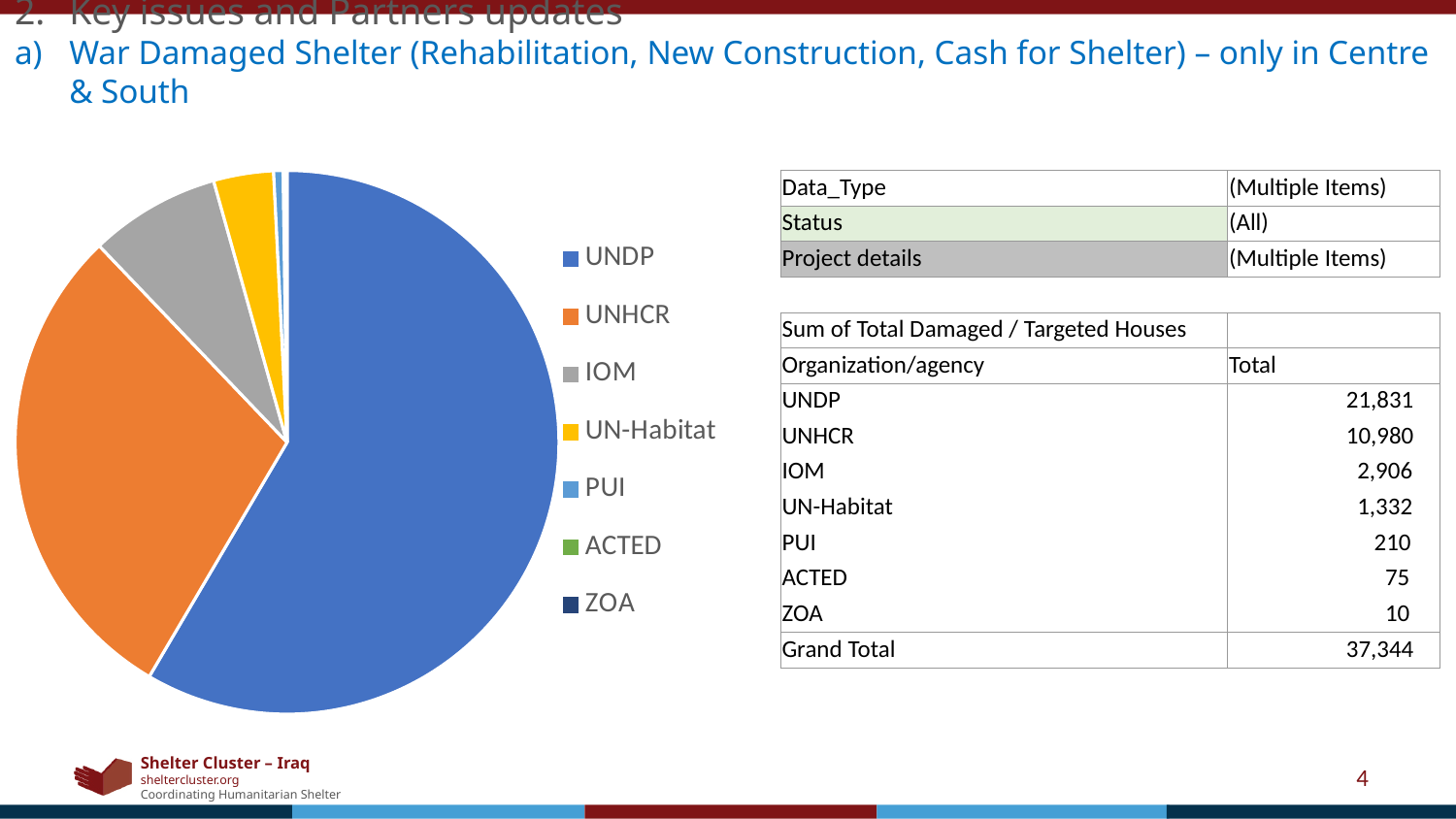
How many entries does the pie chart's legend list? 7 Which organization has the smallest value in the table of Total Damaged / Targeted Houses? ZOA Which has a larger total, UNHCR or IOM? UNHCR What is the difference between the UNDP and UNHCR totals? 10,851 How many organizations are shown as slices in the pie chart? 7 What is the total of damaged / targeted houses for PUI? 210 What is the total of damaged / targeted houses for UNDP? 21,831 Which organization is represented by the orange slice in the pie chart? UNHCR What kind of chart is shown on the slide? pie chart What is the Grand Total of damaged / targeted houses across all organizations? 37,344 What is the total of damaged / targeted houses for IOM? 2,906 Which organization has the largest slice of the pie chart? UNDP